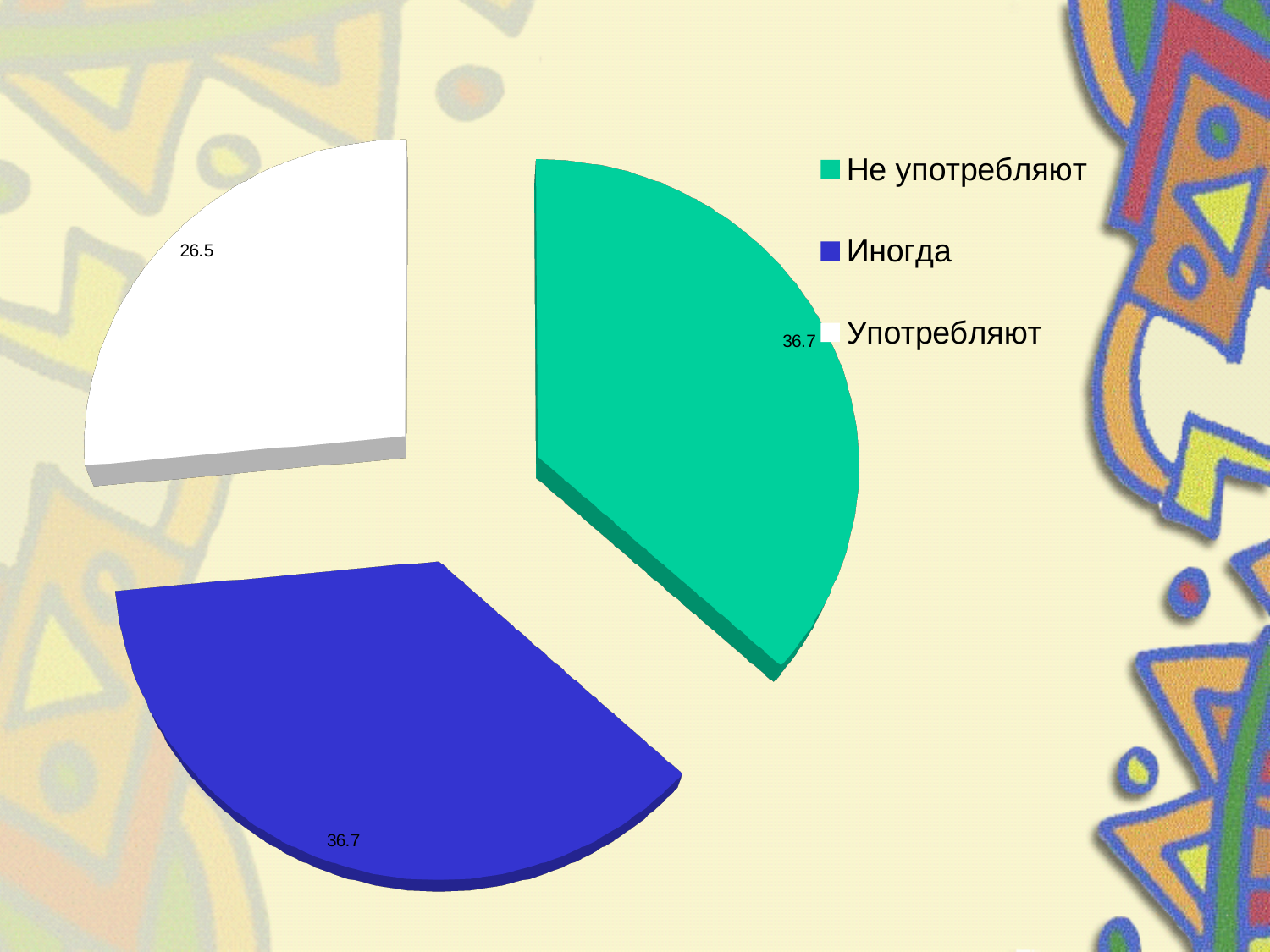
What value is shown for the Не употребляют slice? 36.7 How many entries does the legend list? 3 Which is larger, the value for Не употребляют or the value for Употребляют? Не употребляют Which category has the smallest slice of the pie? Употребляют What is the difference between the values for Иногда and Употребляют? 10.2 What value is shown for the Иногда slice? 36.7 What is the difference between the values for Не употребляют and Употребляют? 10.2 What colour is the Иногда slice? Blue What value is shown for the Употребляют slice? 26.5 How many slices does the pie chart have? 3 What kind of chart is shown on the slide? Pie chart Which is larger, the value for Иногда or the value for Употребляют? Иногда